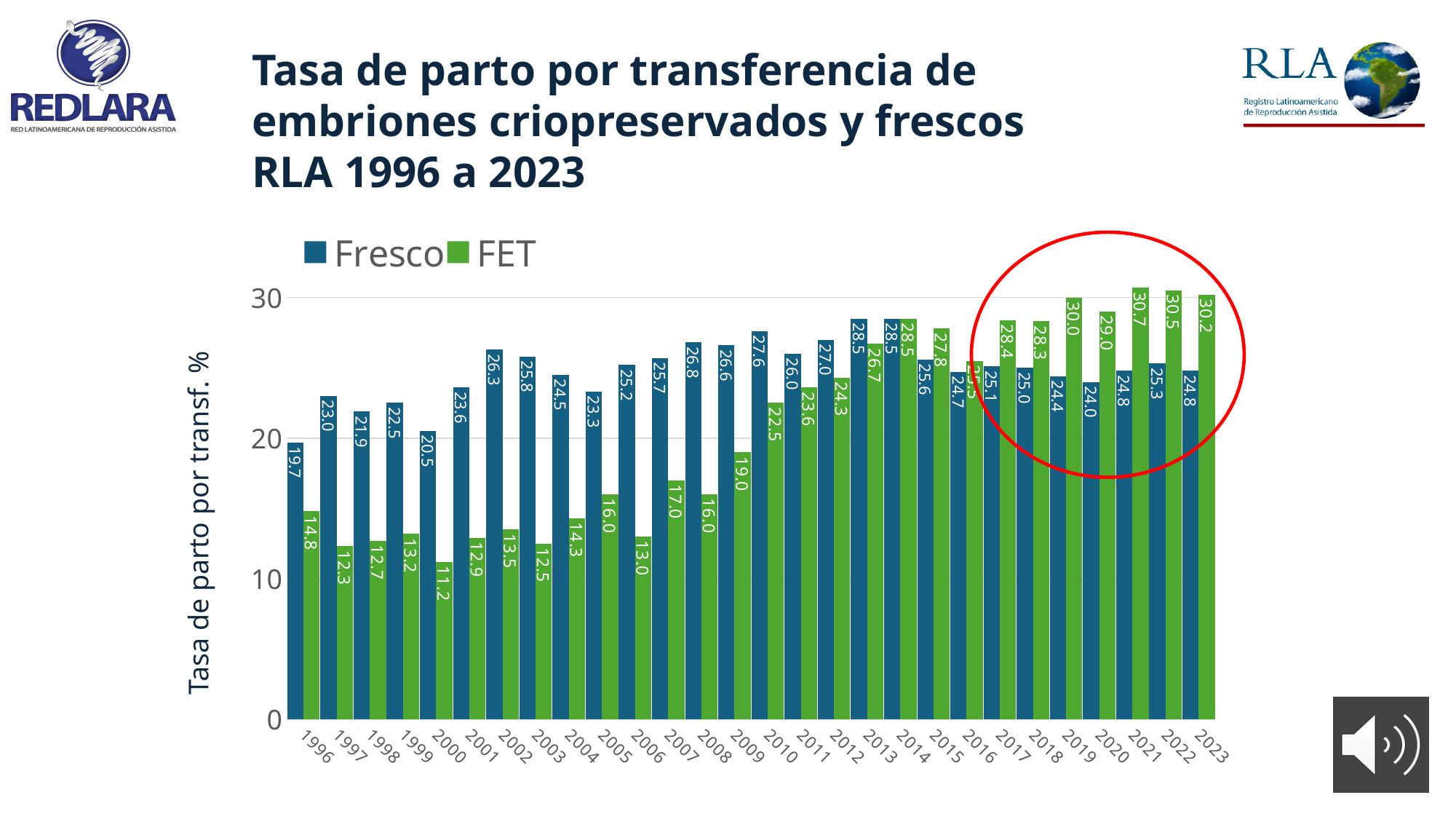
What is the Fresco value for 1996? 19.7 In which year is the FET value lowest? 2000 What is the difference between the FET and Fresco values in 2023? 5.4 Do the FET values generally rise or fall from 2009 to 2023? Rise How many years are shown on the x axis? 28 Which is larger in 2010, the Fresco value or the FET value? Fresco In which year is the FET value highest? 2021 What is the FET value for 2000? 11.2 What is the FET value for 2021? 30.7 What kind of chart is shown on the slide? Bar chart How many series does the legend list? 2 In which year is the Fresco value lowest? 1996